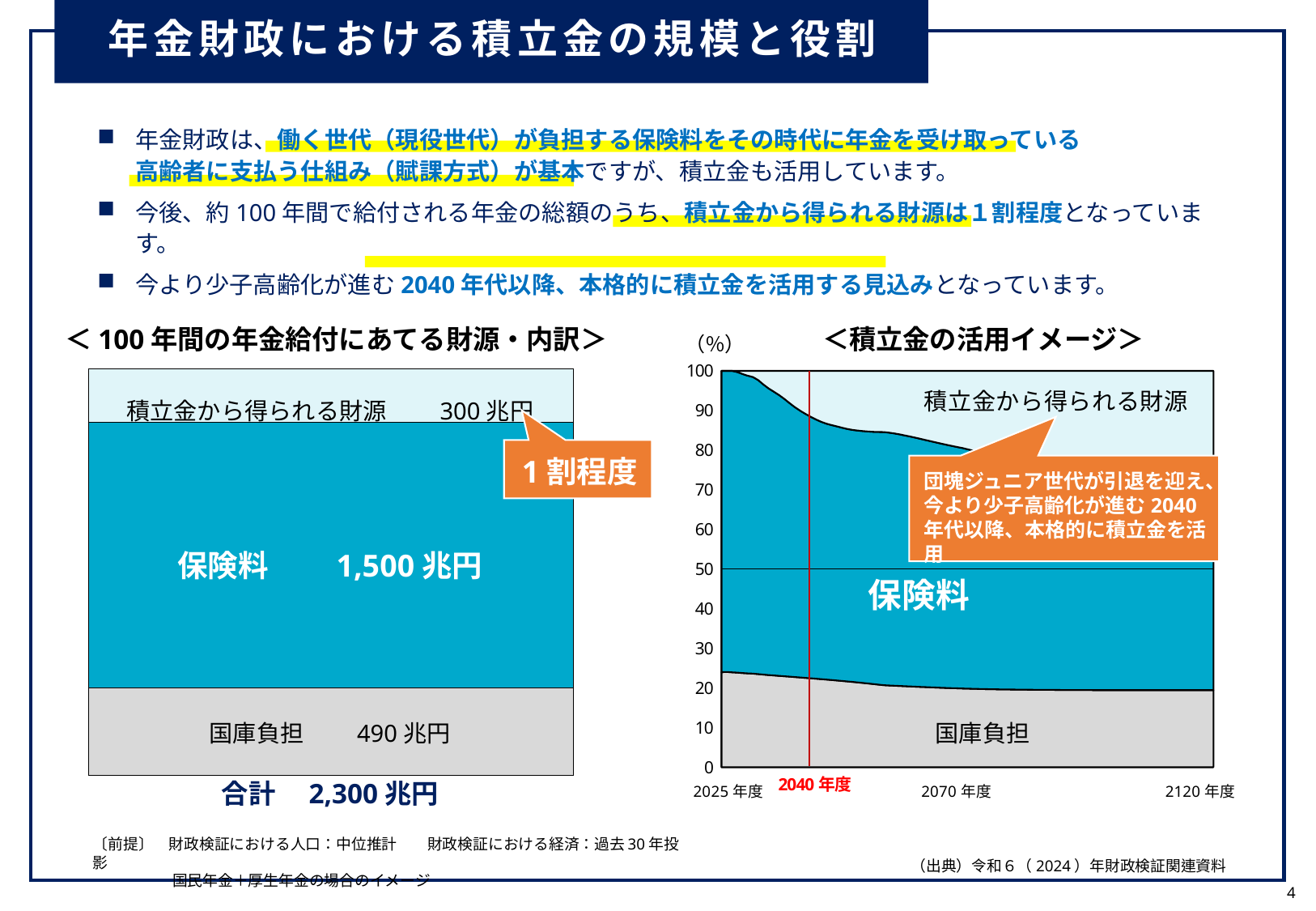
In the left chart <100年間の年金給付にあてる財源・内訳>, what is the value for 積立金から得られる財源? 300兆円 In the left chart <100年間の年金給付にあてる財源・内訳>, what is the value for 保険料? 1,500兆円 In the left chart <100年間の年金給付にあてる財源・内訳>, which segment is the largest? 保険料 In the left chart <100年間の年金給付にあてる財源・内訳>, what is the difference between 保険料 and 国庫負担? 1,010兆円 In the right chart <積立金の活用イメージ>, is the upper boundary of 保険料 at 2070年度 greater or less than 90? less What kind of chart is the right chart <積立金の活用イメージ>? Stacked area chart In the left chart <100年間の年金給付にあてる財源・内訳>, what is the total of the stacked bar? 2,300兆円 In the right chart <積立金の活用イメージ>, does the share of 積立金から得られる財源 rise or fall from 2025年度 to 2120年度? rise In the left chart <100年間の年金給付にあてる財源・内訳>, how many segments make up the stacked bar? 3 In the left chart <100年間の年金給付にあてる財源・内訳>, which segment is the smallest? 積立金から得られる財源 In the left chart <100年間の年金給付にあてる財源・内訳>, what is the value for 国庫負担? 490兆円 In the right chart <積立金の活用イメージ>, is the value of the 国庫負担 boundary at 2025年度 greater or less than 20? greater